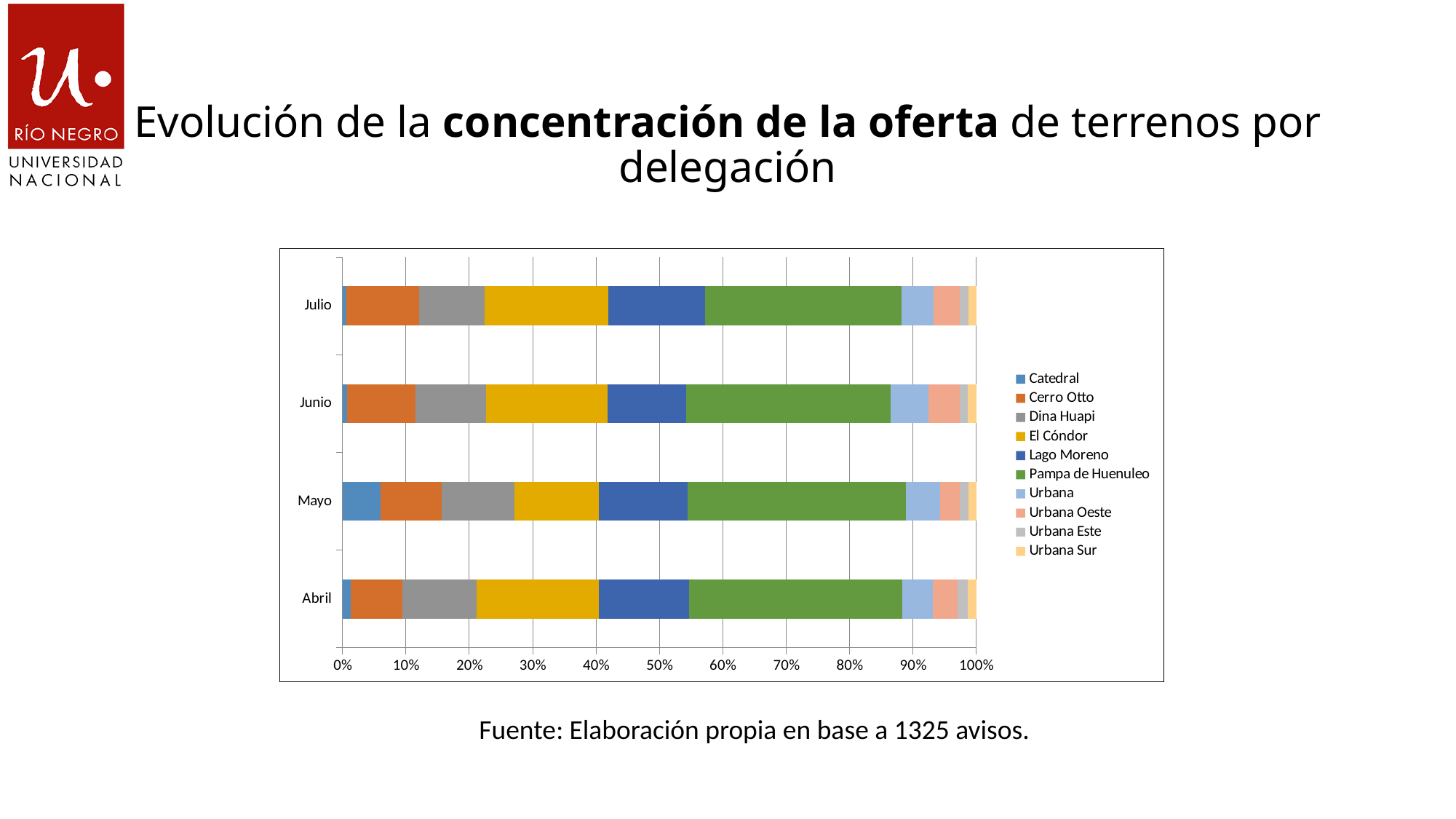
In the Julio bar, which is larger: the Pampa de Huenuleo segment or the El Cóndor segment? Pampa de Huenuleo What kind of chart is shown on the slide? bar chart In which month is the El Cóndor segment the smallest? Mayo Which colour represents Pampa de Huenuleo in the legend? green Which series has the largest segment in the Julio bar? Pampa de Huenuleo How many months (categories) are shown on the chart? 4 In which month is the Catedral segment the largest? Mayo Is the Lago Moreno share in Mayo greater or less than 20%? less Which series has the largest segment in the Abril bar? Pampa de Huenuleo Is the Catedral share in Mayo greater or less than 10%? less Is the Pampa de Huenuleo share in Julio greater or less than 20%? greater How many series does the legend list? 10